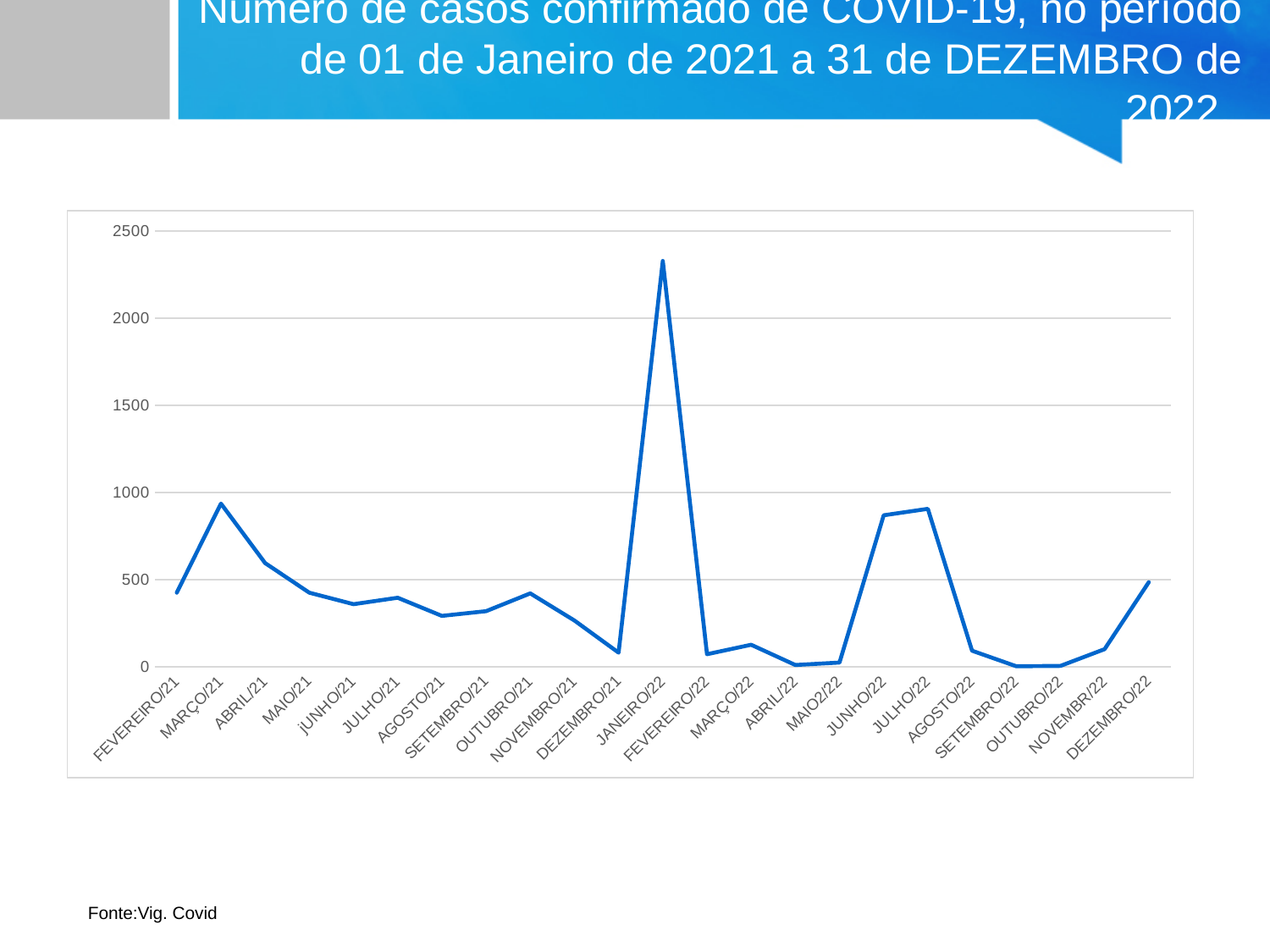
Do the values rise or fall from JANEIRO/22 to FEVEREIRO/22? fall Is the value for MARÇO/21 greater or less than 1000? less Which is larger, the value for MARÇO/21 or the value for JANEIRO/22? JANEIRO/22 Which month has the highest number of confirmed cases? JANEIRO/22 Is the value for JULHO/22 greater or less than 500? greater How many months (data points) are plotted along the x axis? 23 What source is cited below the chart? Fonte:Vig. Covid Is the value for JANEIRO/22 greater or less than 2000? greater Do the values rise or fall from SETEMBRO/22 to DEZEMBRO/22? rise Which is larger, the value for ABRIL/21 or the value for MAIO/21? ABRIL/21 What kind of chart is shown on the slide? line chart